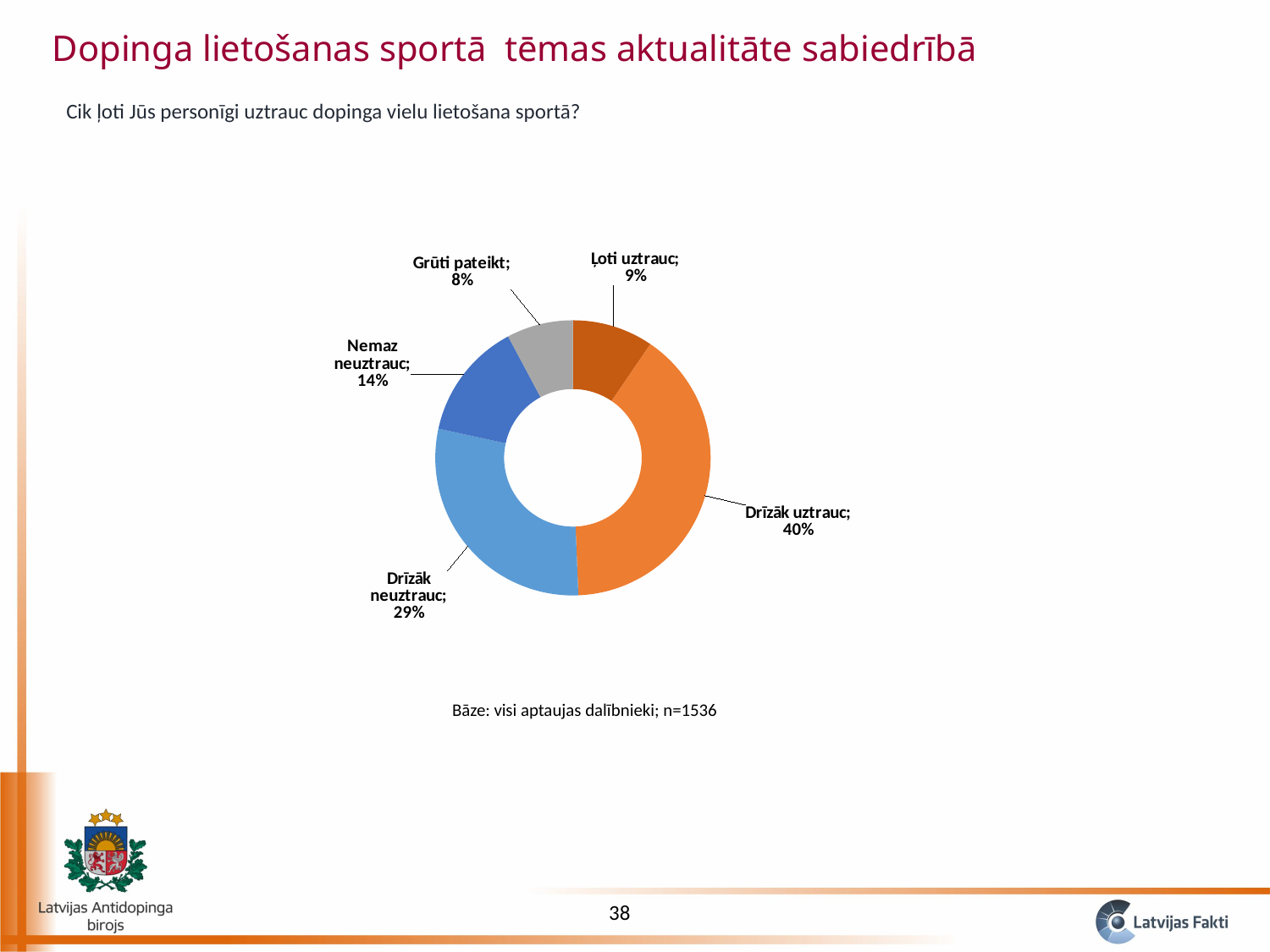
What is the combined share of "Ļoti uztrauc" and "Drīzāk uztrauc"? 49% Which is larger: the share for "Nemaz neuztrauc" or for "Ļoti uztrauc"? Nemaz neuztrauc What share of respondents answered "Nemaz neuztrauc"? 14% Which answer category has the smallest share? Grūti pateikt What share of respondents answered "Ļoti uztrauc"? 9% What kind of chart is shown on the slide? Doughnut (pie) chart What share of respondents answered "Grūti pateikt"? 8% Which answer category has the largest share? Drīzāk uztrauc What share of respondents answered "Drīzāk uztrauc"? 40% What is the sample size (n) stated below the chart? n=1536 How many answer categories are shown in the chart? 5 What is the difference in percentage points between "Drīzāk uztrauc" and "Drīzāk neuztrauc"? 11 percentage points